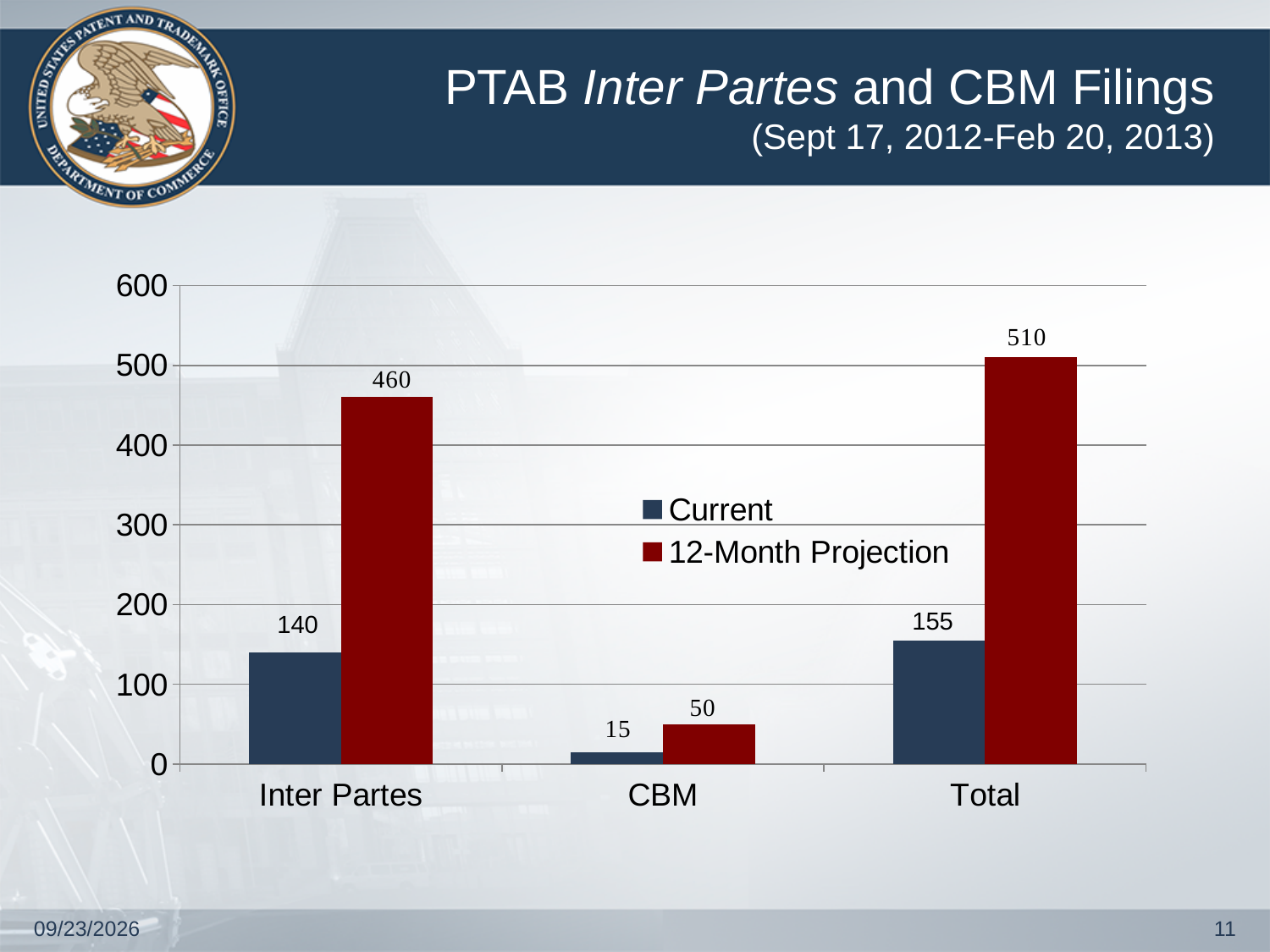
Is the 12-Month Projection value for Inter Partes greater or less than 400? greater What kind of chart is shown on the slide? bar chart Which category has the highest 12-Month Projection value? Total How many series does the legend list? 2 What is the Current value for CBM? 15 What is the difference between the 12-Month Projection and Current values for Inter Partes? 320 How many categories are shown on the x axis? 3 Which category has the lowest Current value? CBM What is the 12-Month Projection value for Total? 510 What is the 12-Month Projection value for CBM? 50 What is the Current value for Inter Partes? 140 Which is larger, the Current value for Total or the 12-Month Projection value for CBM? Current value for Total